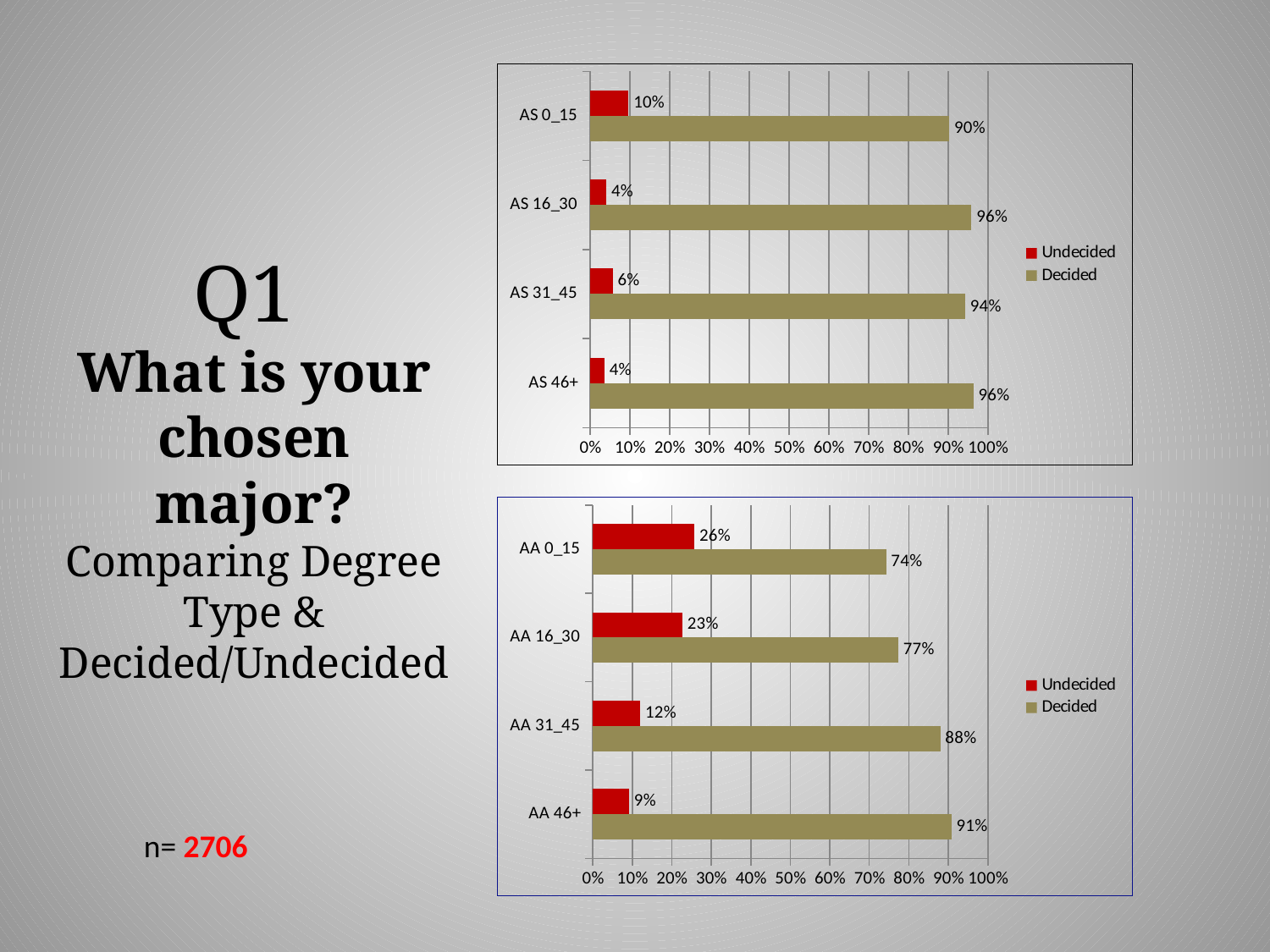
In the top chart (AS categories), what is the Undecided value for AS 0_15? 10% In the bottom chart (AA categories), what is the difference between the Decided values for AA 31_45 and AA 0_15? 14% In the top chart (AS categories), which is larger: the Undecided value for AS 0_15 or for AS 31_45? AS 0_15 How many categories are shown in the bottom chart (AA categories)? 4 In the bottom chart (AA categories), what is the Decided value for AA 46+? 91% In the bottom chart (AA categories), which category has the highest Undecided value? AA 0_15 In the top chart (AS categories), what is the Decided value for AS 31_45? 94% In the bottom chart (AA categories), what is the Undecided value for AA 16_30? 23% What kind of chart is the top chart (AS categories)? Bar chart In the bottom chart (AA categories), which colour represents the Decided series? Tan/gold How many series does the legend of the top chart (AS categories) list? 2 In the top chart (AS categories), which category has the lowest Decided value? AS 0_15